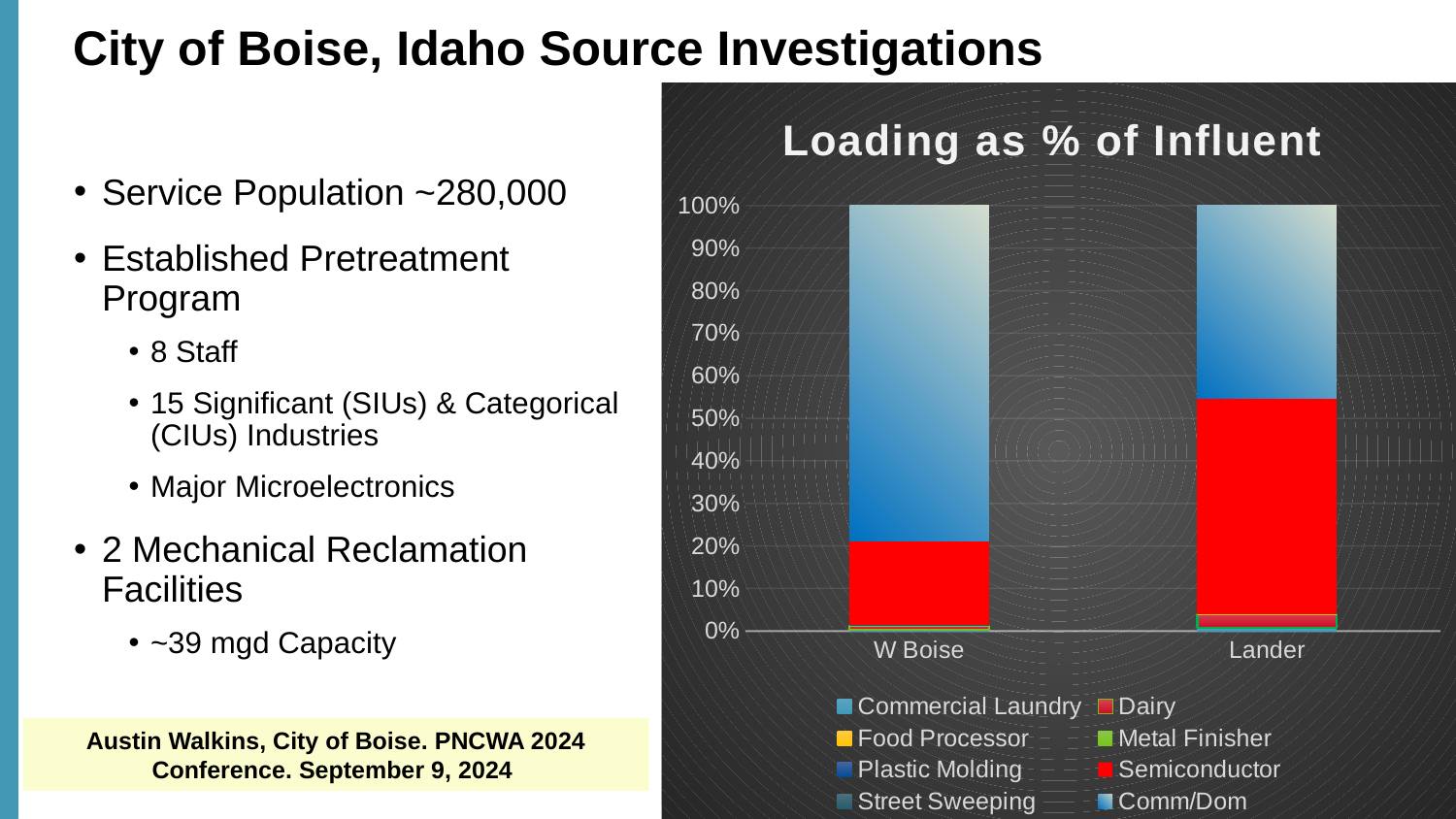
Is the Comm/Dom value for Lander greater or less than 50%? less Is the Comm/Dom value for W Boise greater or less than 70%? greater Which colour represents Semiconductor in the chart? Red Which category has the larger Comm/Dom share, W Boise or Lander? W Boise What is the total height of the stacked bar for W Boise? 100% What is the title of the chart? Loading as % of Influent How many series does the chart legend list? 8 What kind of chart is shown on the slide? Stacked bar chart Which category has the larger Semiconductor share, W Boise or Lander? Lander Is the Semiconductor value for W Boise greater or less than 30%? less How many categories are shown on the x axis of the chart? 2